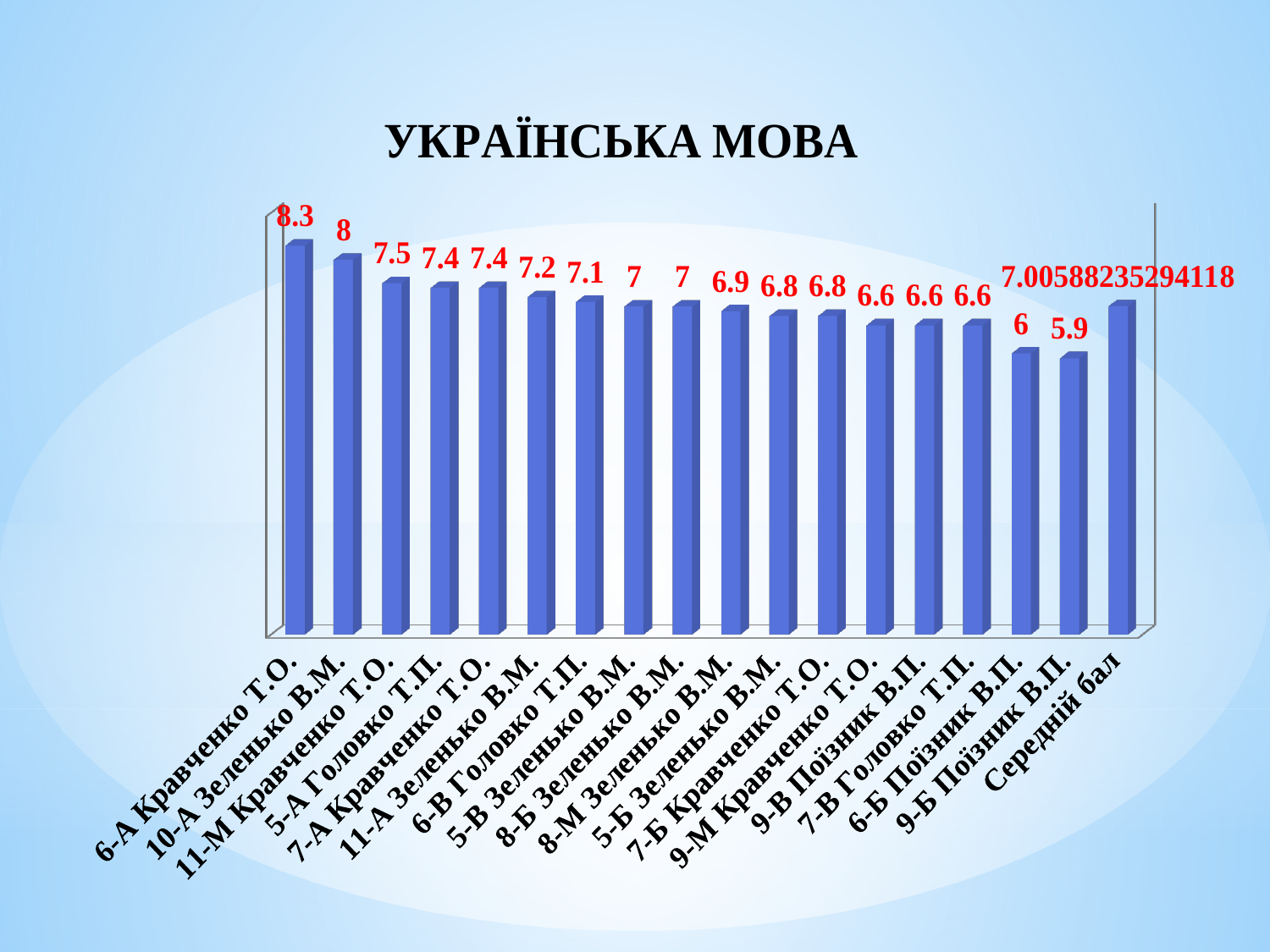
What is the value for 6-А Кравченко Т.О.? 8.3 How many bars are plotted on the chart? 18 What is the value for 9-Б Поїзник В.П.? 5.9 What is the value shown for Середній бал? 7.00588235294118 What is the value for 11-А Зеленько В.М.? 7.2 What is the difference between the values for 10-А Зеленько В.М. and 6-Б Поїзник В.П.? 2 Which is larger, the value for 11-М Кравченко Т.О. or the value for 8-М Зеленько В.М.? 11-М Кравченко Т.О. What is the difference between the values for 6-А Кравченко Т.О. and 9-Б Поїзник В.П.? 2.4 Which category has the highest value? 6-А Кравченко Т.О. What kind of chart is shown on the slide? Bar chart Which category has the lowest value? 9-Б Поїзник В.П. What is the title of the chart? УКРАЇНСЬКА МОВА